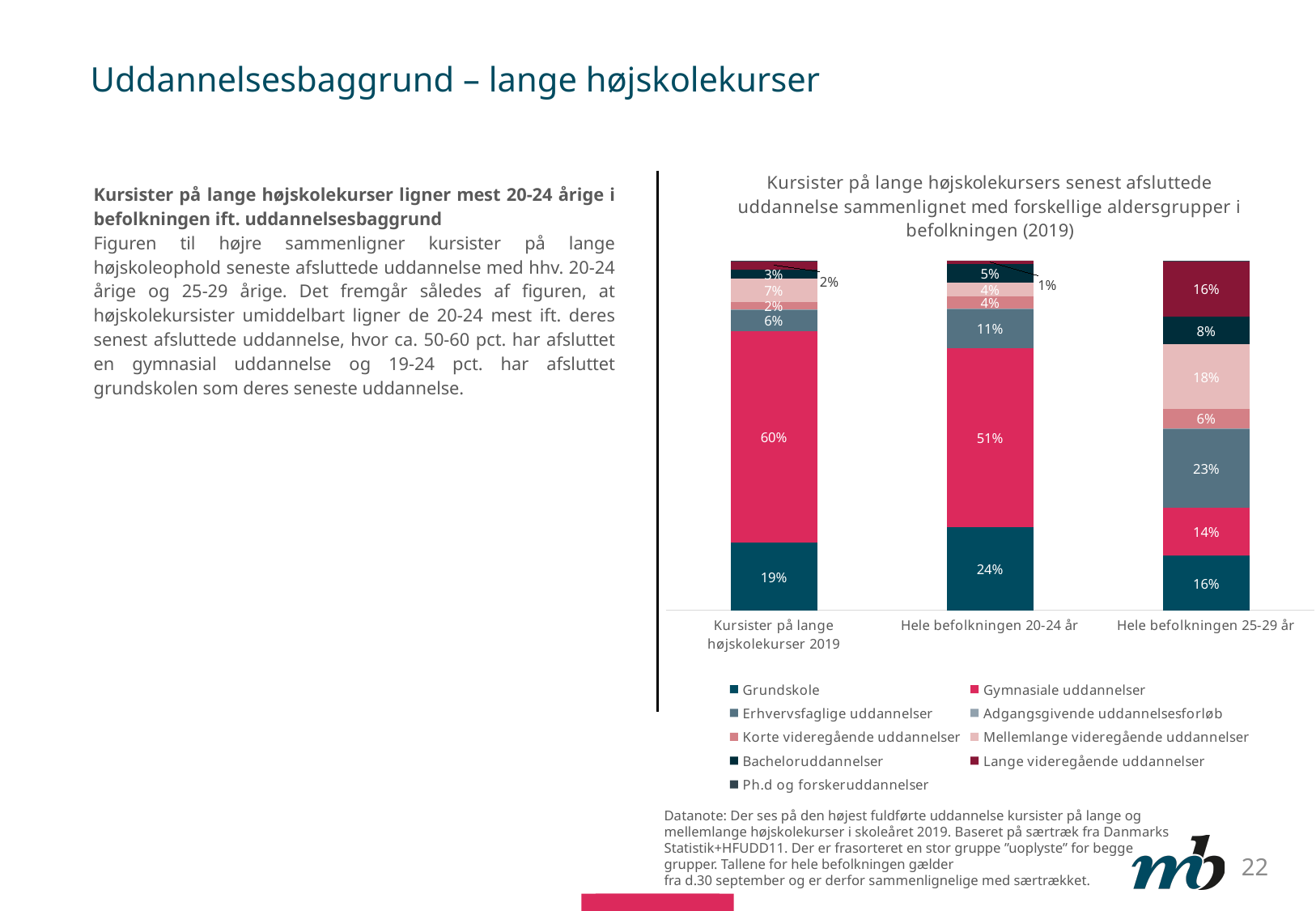
What is the Erhvervsfaglige uddannelser share for Hele befolkningen 25-29 år? 23% What is the Grundskole share for Hele befolkningen 20-24 år? 24% Which is larger: the Erhvervsfaglige uddannelser share for Hele befolkningen 20-24 år or for Hele befolkningen 25-29 år? Hele befolkningen 25-29 år What is the difference in Gymnasiale uddannelser share between Kursister på lange højskolekurser 2019 and Hele befolkningen 20-24 år? 9 percentage points What is the Gymnasiale uddannelser share for Kursister på lange højskolekurser 2019? 60% What kind of chart is shown on the slide? Stacked bar chart What year is given in parentheses in the chart title? 2019 Which category has the lowest Grundskole share? Hele befolkningen 25-29 år What is the Lange videregående uddannelser share for Hele befolkningen 25-29 år? 16% How many categories (bars) are shown on the x axis? 3 How many series does the legend list? 9 Which category has the highest Gymnasiale uddannelser share? Kursister på lange højskolekurser 2019